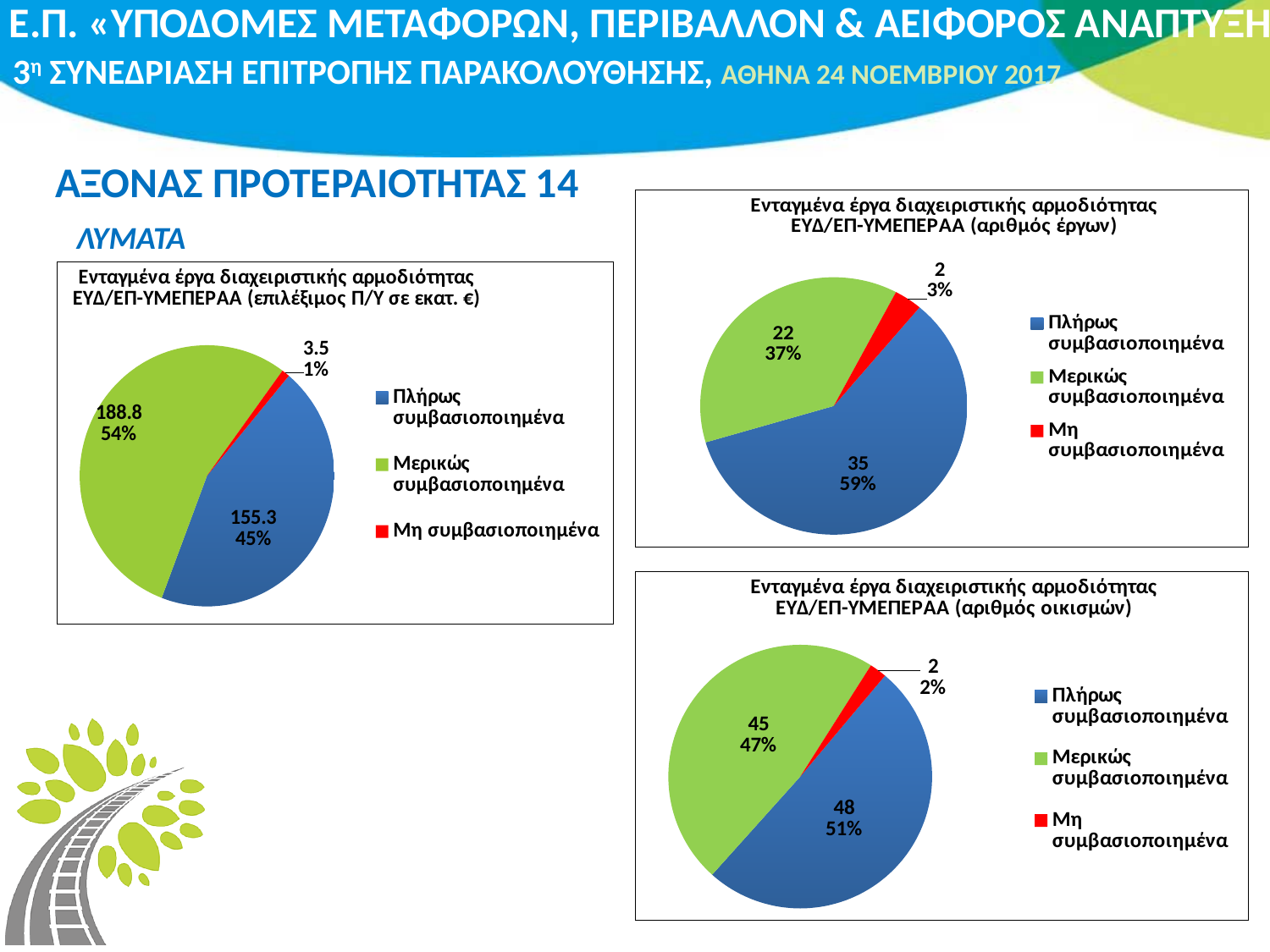
In the top-right chart (αριθμός έργων), what is the value for 'Πλήρως συμβασιοποιημένα'? 35 In the top-right chart (αριθμός έργων), what share of the pie does 'Μερικώς συμβασιοποιημένα' represent? 37% In the top-right chart (αριθμός έργων), which category has the largest slice? Πλήρως συμβασιοποιημένα In the top-right chart (αριθμός έργων), what is the total number of projects across all three categories? 59 In the bottom-right chart (αριθμός οικισμών), which is larger: 'Πλήρως συμβασιοποιημένα' or 'Μερικώς συμβασιοποιημένα'? Πλήρως συμβασιοποιημένα In the left chart (επιλέξιμος Π/Υ σε εκατ. €), what share of the pie does 'Πλήρως συμβασιοποιημένα' represent? 45% In the left chart (επιλέξιμος Π/Υ σε εκατ. €), which category has the smallest slice? Μη συμβασιοποιημένα In the bottom-right chart (αριθμός οικισμών), what is the value for 'Μερικώς συμβασιοποιημένα'? 45 How many categories does the legend of the top-right chart (αριθμός έργων) list? 3 In the chart titled 'Ενταγμένα έργα διαχειριστικής αρμοδιότητας ΕΥΔ/ΕΠ-ΥΜΕΠΕΡΑΑ (επιλέξιμος Π/Υ σε εκατ. €)' on the left, what is the value for 'Μερικώς συμβασιοποιημένα'? 188.8 What type of chart is the bottom-right chart (αριθμός οικισμών)? Pie chart In the left chart (επιλέξιμος Π/Υ σε εκατ. €), what is the difference between the values for 'Μερικώς συμβασιοποιημένα' and 'Πλήρως συμβασιοποιημένα'? 33.5